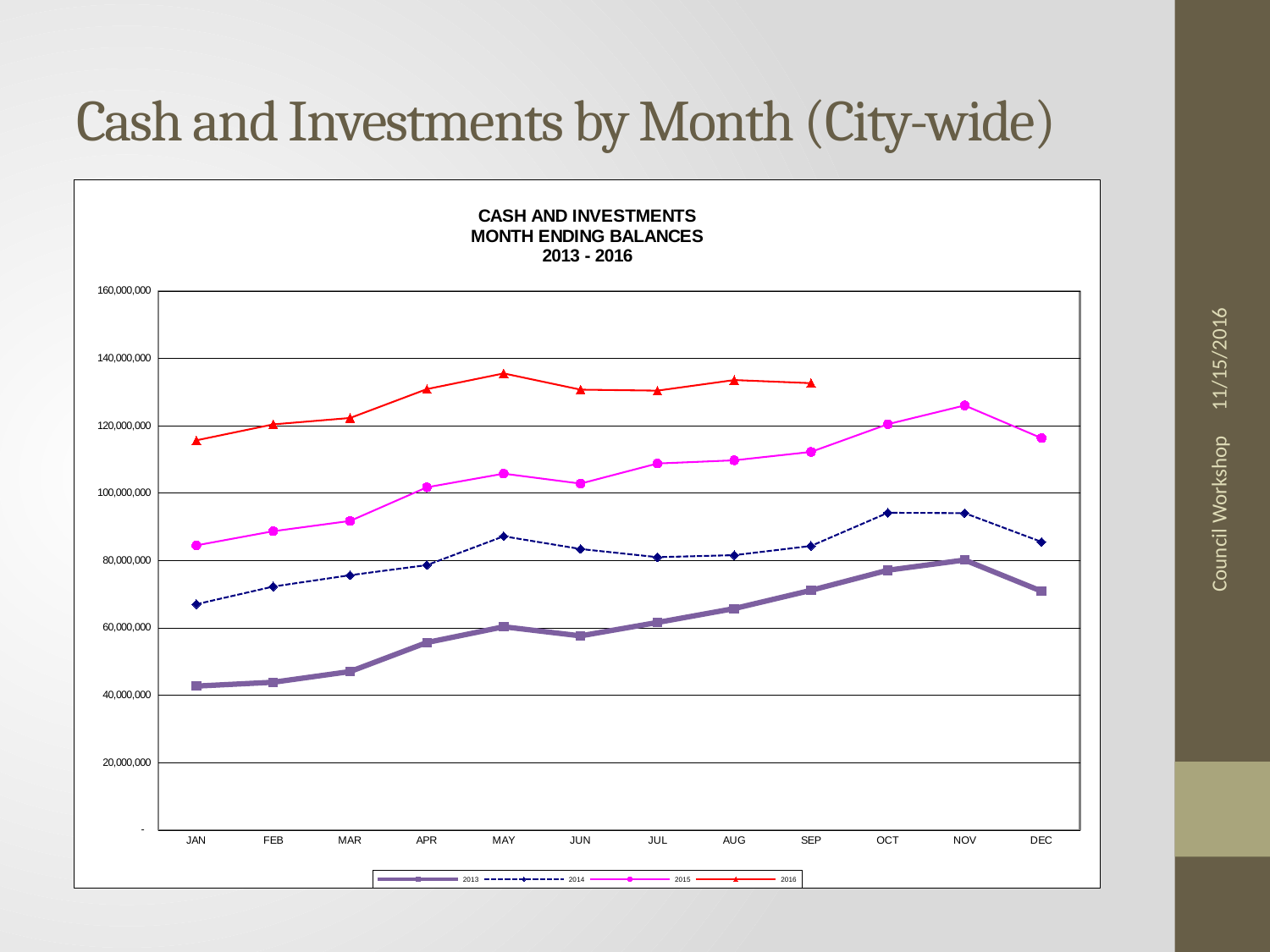
Is the value for 2016 in MAY greater or less than 120,000,000? greater Is the value for 2013 in JAN greater or less than 60,000,000? less What kind of chart is shown on the slide? Line chart In which month does the 2014 series have its lowest value? JAN In which month does the 2015 series reach its highest value? NOV Is the value for 2015 in NOV greater or less than 120,000,000? greater How many months are shown on the x axis? 12 In JAN, which series has the larger value, 2016 or 2013? 2016 How many series does the legend list? 4 What is the last month for which the 2016 series has a data point? SEP Does the 2013 series rise or fall from JAN to NOV? Rise